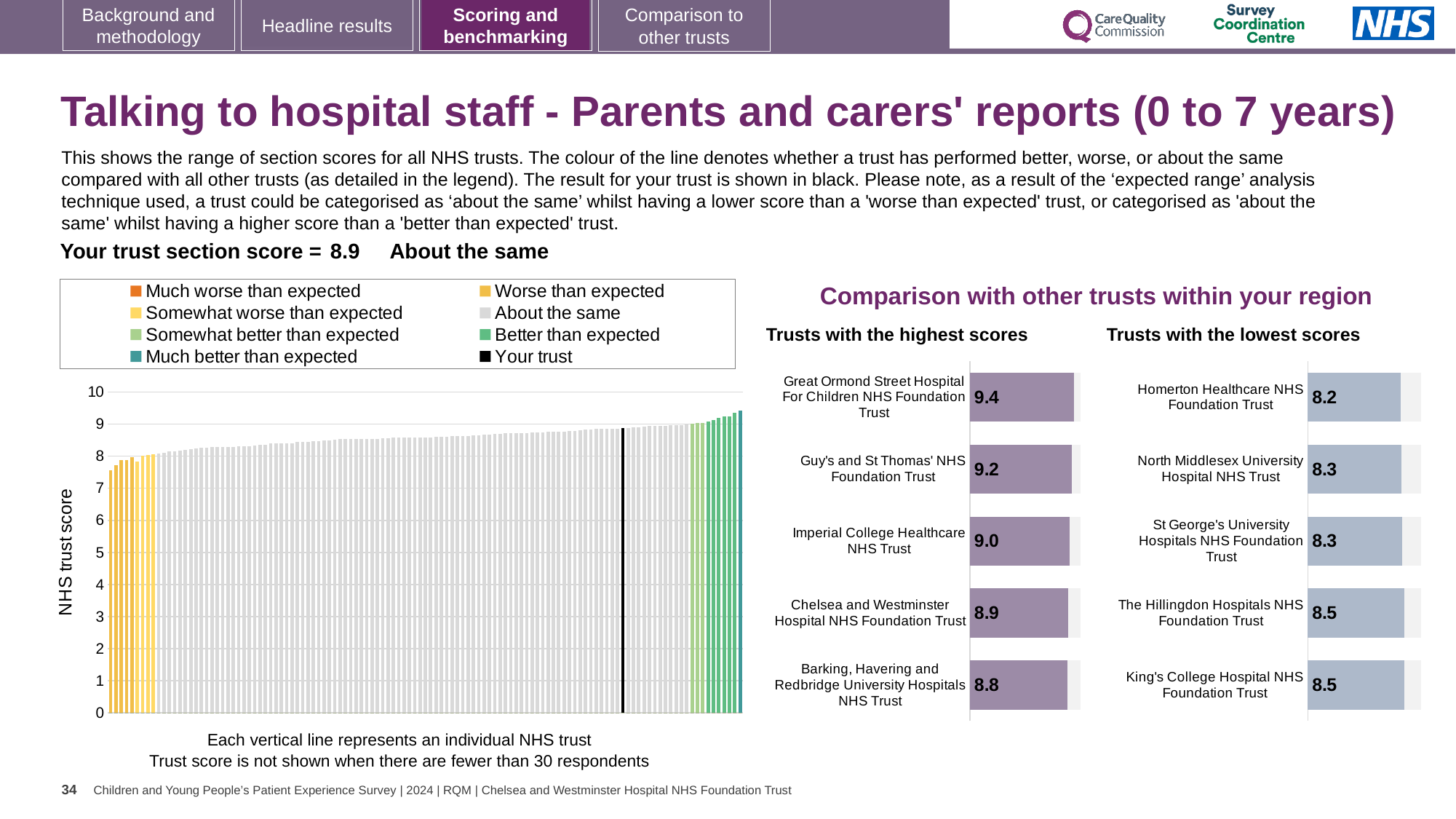
How many trusts are shown in the 'Trusts with the highest scores' chart? 5 In the 'Trusts with the highest scores' chart, what is the score for Imperial College Healthcare NHS Trust? 9.0 Which has a higher score: Guy's and St Thomas' NHS Foundation Trust in the highest scores chart, or North Middlesex University Hospital NHS Trust in the lowest scores chart? Guy's and St Thomas' NHS Foundation Trust In the 'Trusts with the highest scores' chart, what is the score for Great Ormond Street Hospital For Children NHS Foundation Trust? 9.4 What type of chart is the large chart on the left showing NHS trust scores? Bar chart In the 'Trusts with the lowest scores' chart, what is the score for Homerton Healthcare NHS Foundation Trust? 8.2 In the 'Trusts with the highest scores' chart, which trust has the highest score? Great Ormond Street Hospital For Children NHS Foundation Trust In the 'Trusts with the lowest scores' chart, what is the score for The Hillingdon Hospitals NHS Foundation Trust? 8.5 In the 'Trusts with the highest scores' chart, what is the difference between the scores of Great Ormond Street Hospital For Children NHS Foundation Trust and Barking, Havering and Redbridge University Hospitals NHS Trust? 0.6 How many entries does the legend of the large chart on the left list? 8 In the 'Trusts with the lowest scores' chart, which trust has the lowest score? Homerton Healthcare NHS Foundation Trust In the 'Trusts with the lowest scores' chart, what is the difference between the scores of King's College Hospital NHS Foundation Trust and Homerton Healthcare NHS Foundation Trust? 0.3